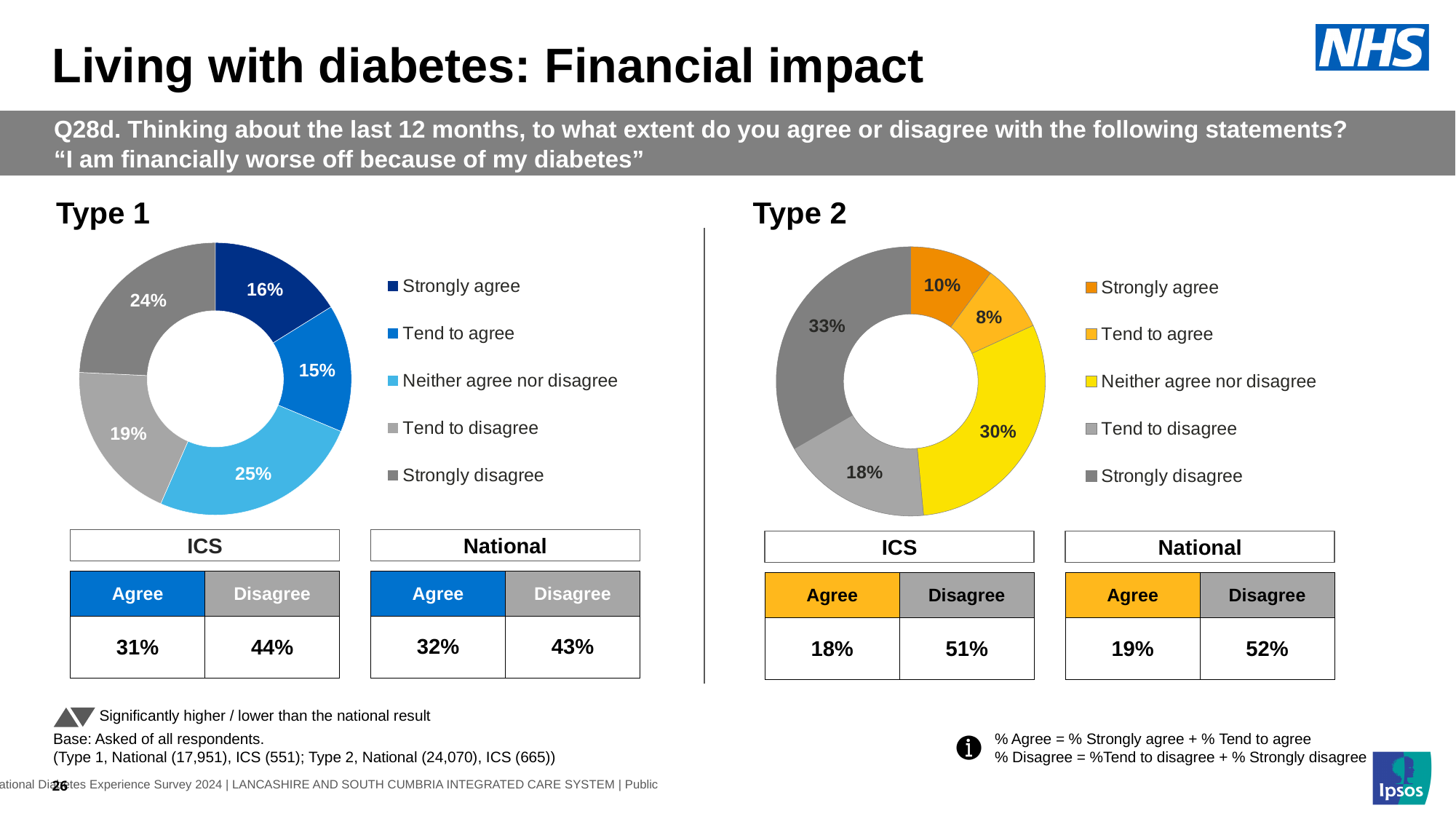
In the Type 2 chart, what percentage of respondents strongly disagree? 33% In the Type 2 chart, what colour represents Neither agree nor disagree? Yellow How many response categories does the Type 2 chart show? 5 In the Type 1 chart, what percentage of respondents strongly agree? 16% In the Type 1 chart, what is the combined share of Strongly agree and Tend to agree? 31% In the Type 2 chart, what percentage of respondents tend to agree? 8% In the Type 1 chart, which is larger: Strongly disagree or Tend to disagree? Strongly disagree In the Type 2 chart, what is the difference between the Strongly disagree and Tend to disagree shares? 15% In the Type 1 chart, which response category has the largest share? Neither agree nor disagree In the Type 2 chart, which response category has the smallest share? Tend to agree What kind of chart is used for Type 1? Donut (pie) chart In the Type 1 chart, what percentage of respondents neither agree nor disagree? 25%